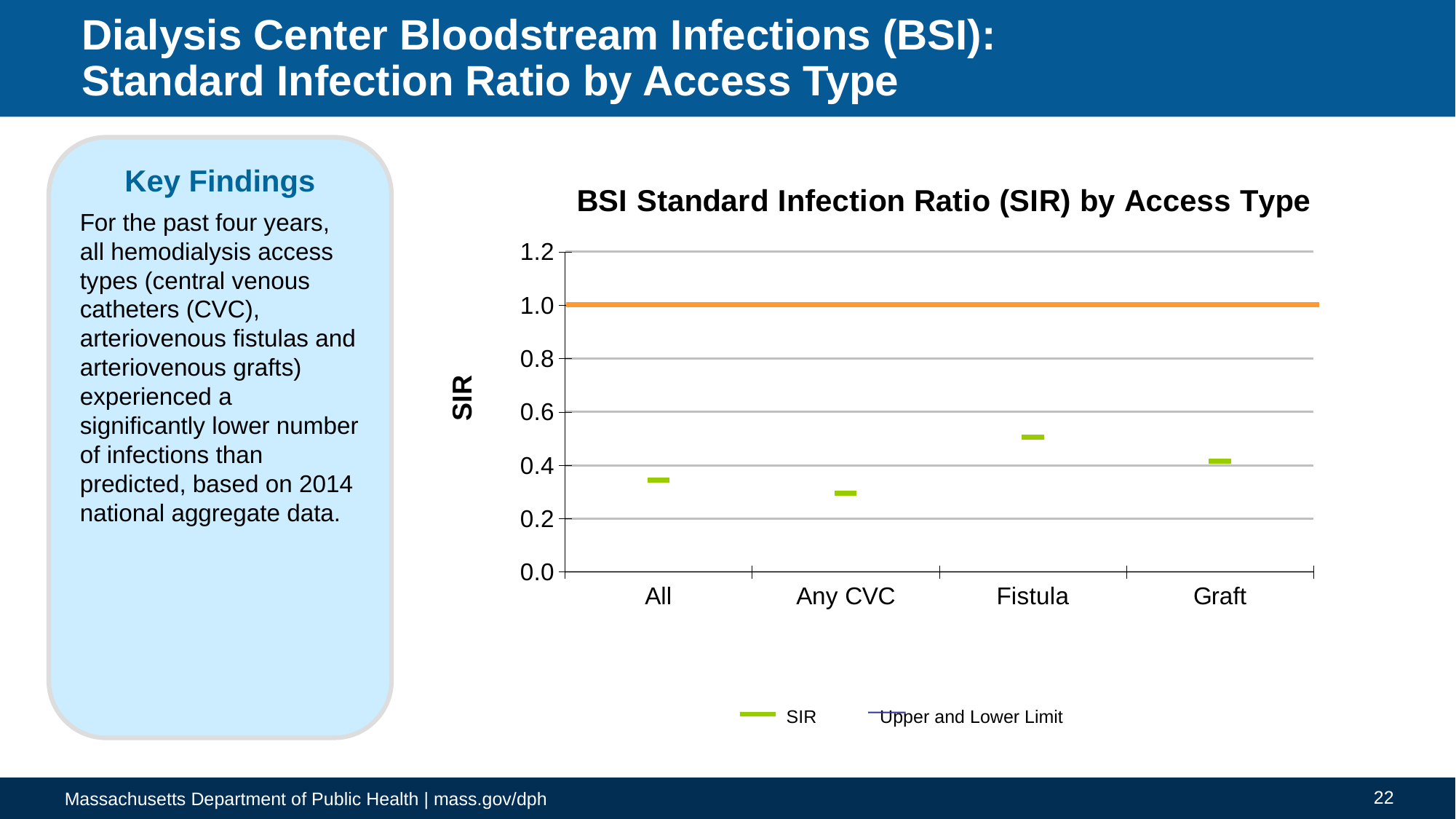
Is the SIR value for Graft greater or less than 0.6? less Is the SIR value for Fistula greater or less than 0.6? less Which access type has the highest SIR value? Fistula Is the SIR value for Any CVC greater or less than 0.4? less How many series does the legend list? 2 Which access type has the lowest SIR value? Any CVC Which has a larger SIR value, All or Any CVC? All Which has a larger SIR value, Fistula or Graft? Fistula How many access types are shown on the x axis? 4 At what value does the Upper and Lower Limit line sit on the SIR axis? 1.0